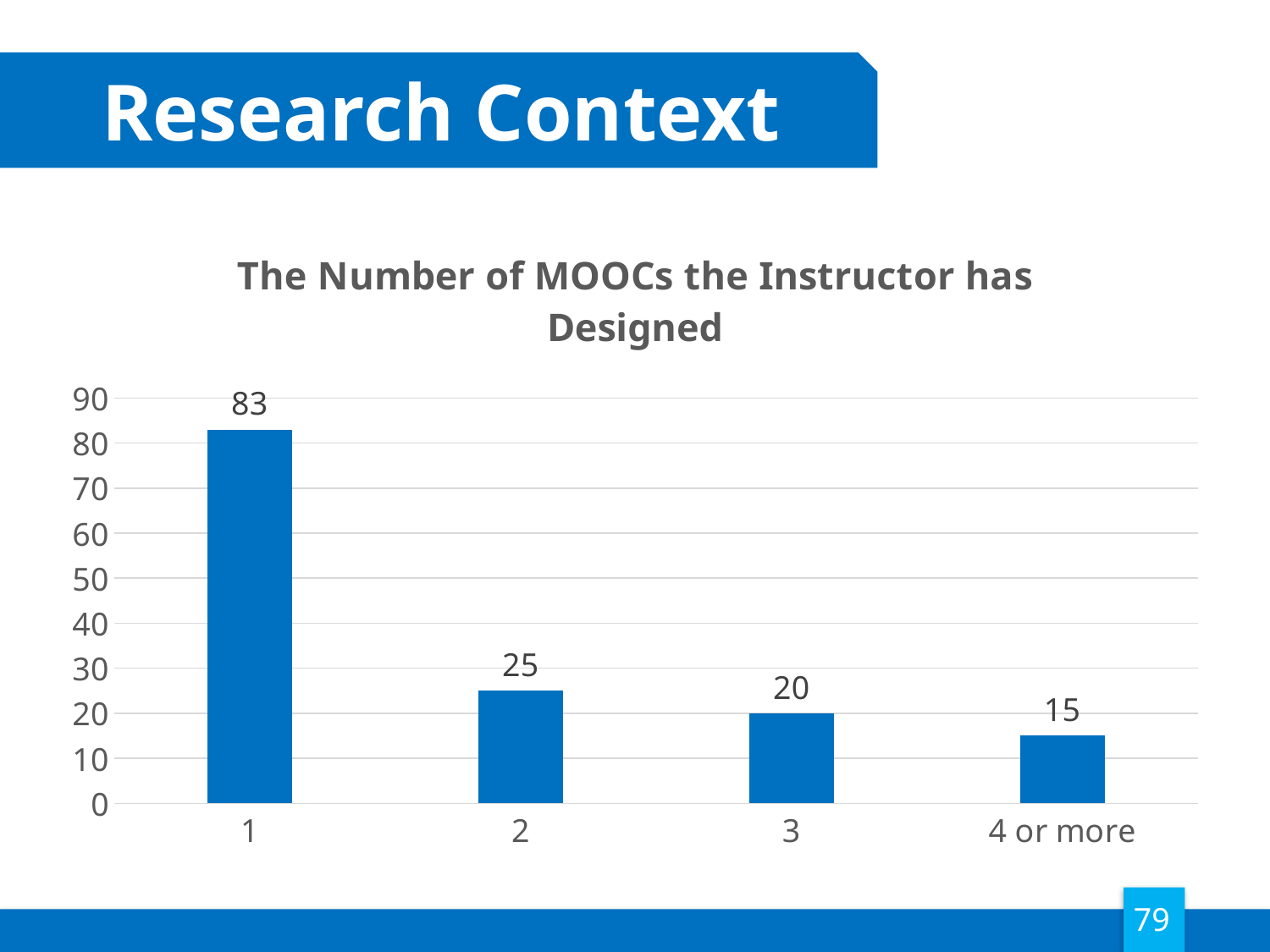
What is the difference between the values for category '1' and category '2'? 58 What is the title of the chart? The Number of MOOCs the Instructor has Designed Which category has the highest value? 1 How many categories are shown on the x axis? 4 Is the value for category '1' greater or less than 80? greater What is the difference between the values for category '3' and category '4 or more'? 5 Which category has the lowest value? 4 or more Which is larger, the value for category '2' or the value for category '3'? 2 What is the value for the category '1' in the chart? 83 What is the value for the category '3'? 20 What is the value for the category '4 or more'? 15 What kind of chart is shown on the slide? bar chart